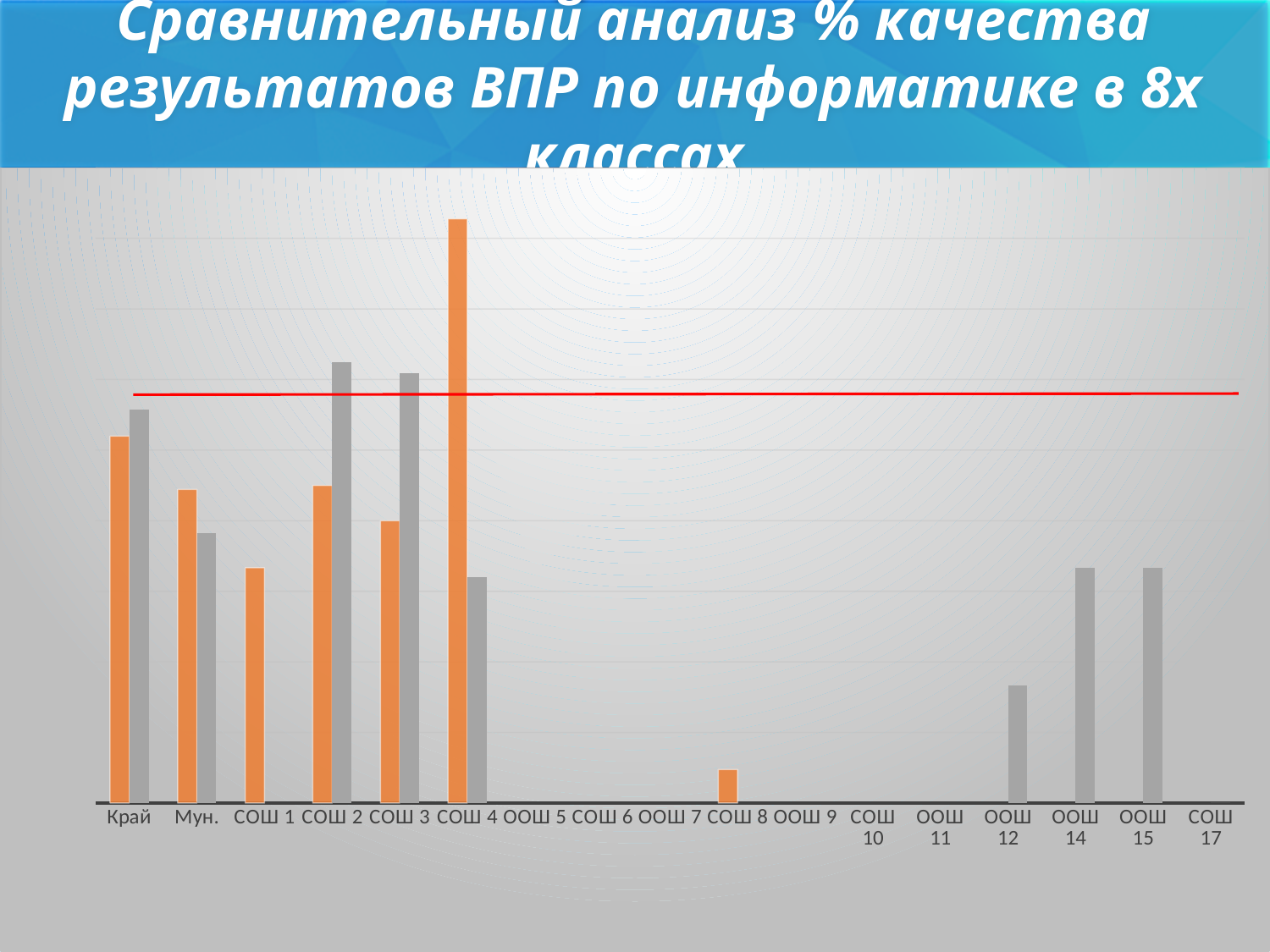
Which category has the tallest bar in the chart? СОШ 4 Which is larger, the grey bar for ООШ 12 or the grey bar for ООШ 14? ООШ 14 Which category has the shortest non-zero orange bar? СОШ 8 How many categories are listed along the x axis of the chart? 17 Which category has the tallest orange bar? СОШ 4 What colour is the horizontal reference line drawn across the chart? red Which is larger, the orange bar for Край or the orange bar for Мун.? Край What kind of chart is shown on the slide? bar chart For СОШ 4, which bar is taller, the orange one or the grey one? orange What is the title of the slide containing the chart? Сравнительный анализ % качества результатов ВПР по информатике в 8х классах Which category has the tallest grey bar? СОШ 2